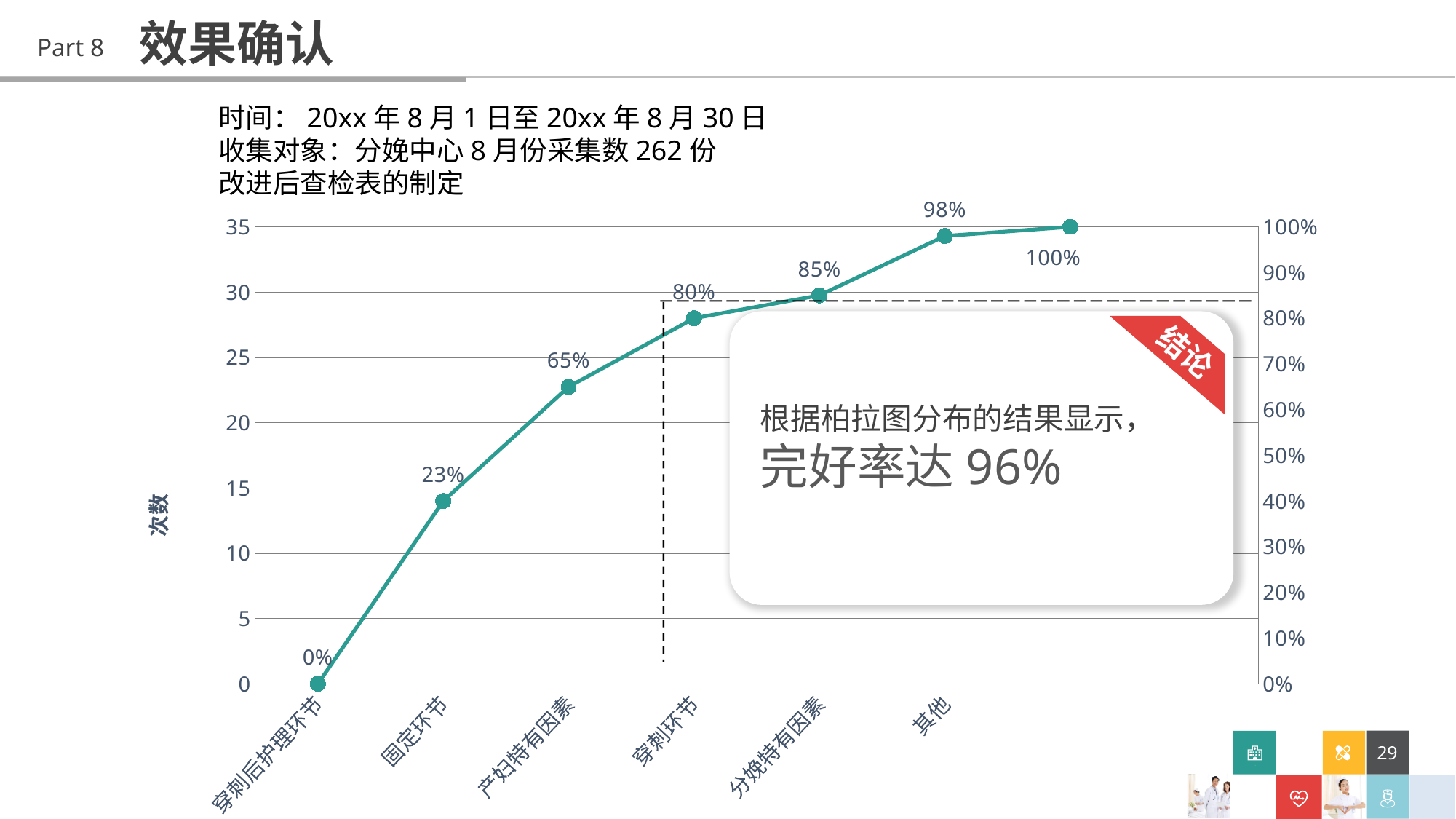
How many data points are plotted on the line? 7 What is the highest value labelled on the line? 100% What kind of chart is shown on the slide? line chart What is the difference in percentage points between the values for 穿刺环节 and 固定环节? 57 What is the value labelled at the point for 其他? 98% Do the values rise or fall from left to right along the x axis? rise What is the title of the left vertical axis? 次数 What is the cumulative percentage value labelled at the point for 固定环节? 23% What is the lowest value labelled on the line? 0% What is the value labelled at the point for 分娩特有因素? 85% What is the value labelled at the point for 产妇特有因素? 65% What is the value labelled at the point for 穿刺环节? 80%